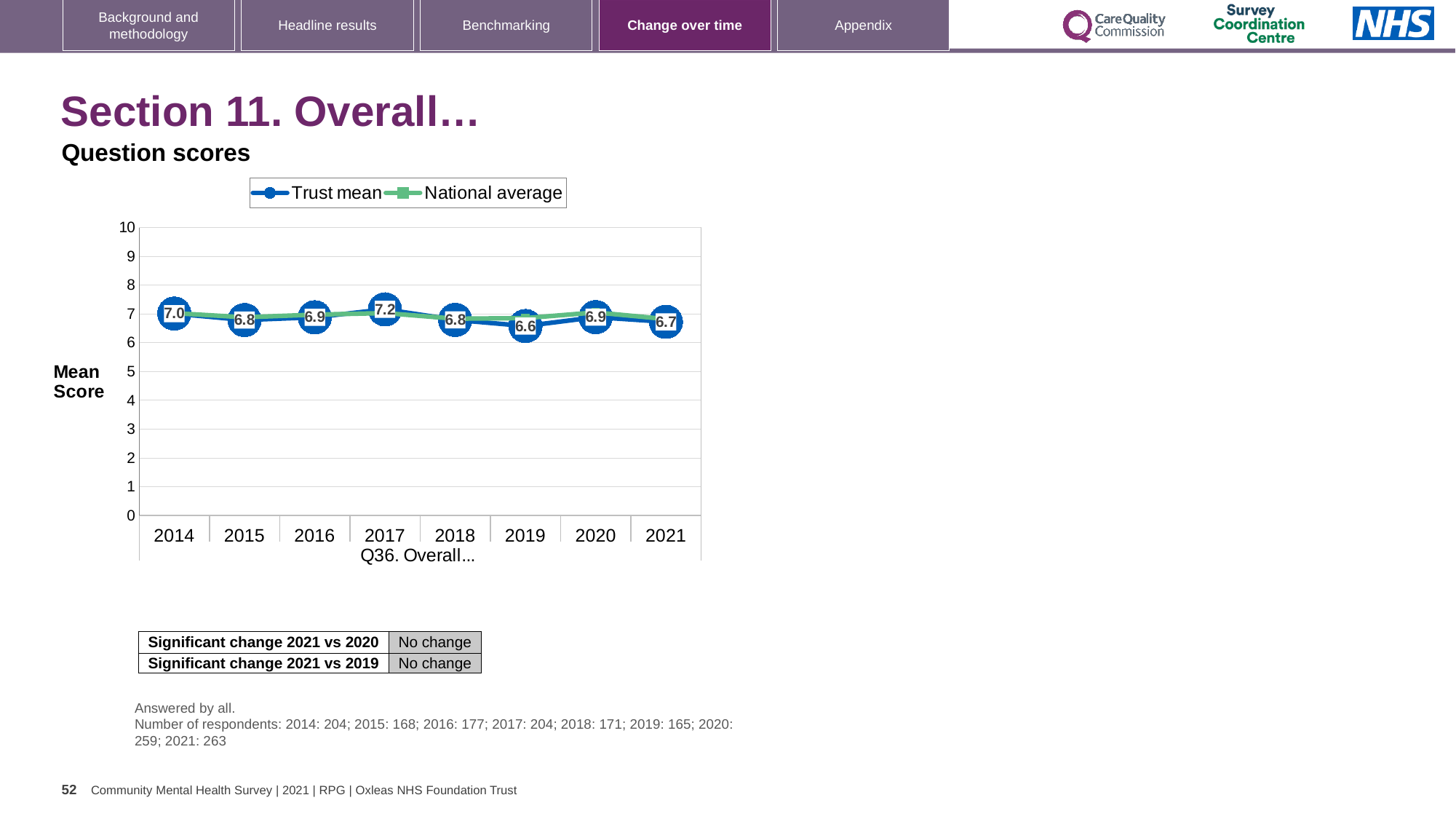
Does the Trust mean score rise or fall from 2017 to 2019? Fall What kind of chart is shown on the slide? Line chart How many series does the legend list? 2 What is the Trust mean score for 2014? 7.0 How many years are shown on the x axis of the chart? 8 What is the Trust mean score for 2021? 6.7 What is the difference between the Trust mean scores for 2017 and 2019? 0.6 Which year has the larger Trust mean score, 2020 or 2021? 2020 What is the Trust mean score for 2017? 7.2 In which year is the Trust mean score lowest? 2019 Is the National average value for 2014 greater or less than 5? greater In which year is the Trust mean score highest? 2017